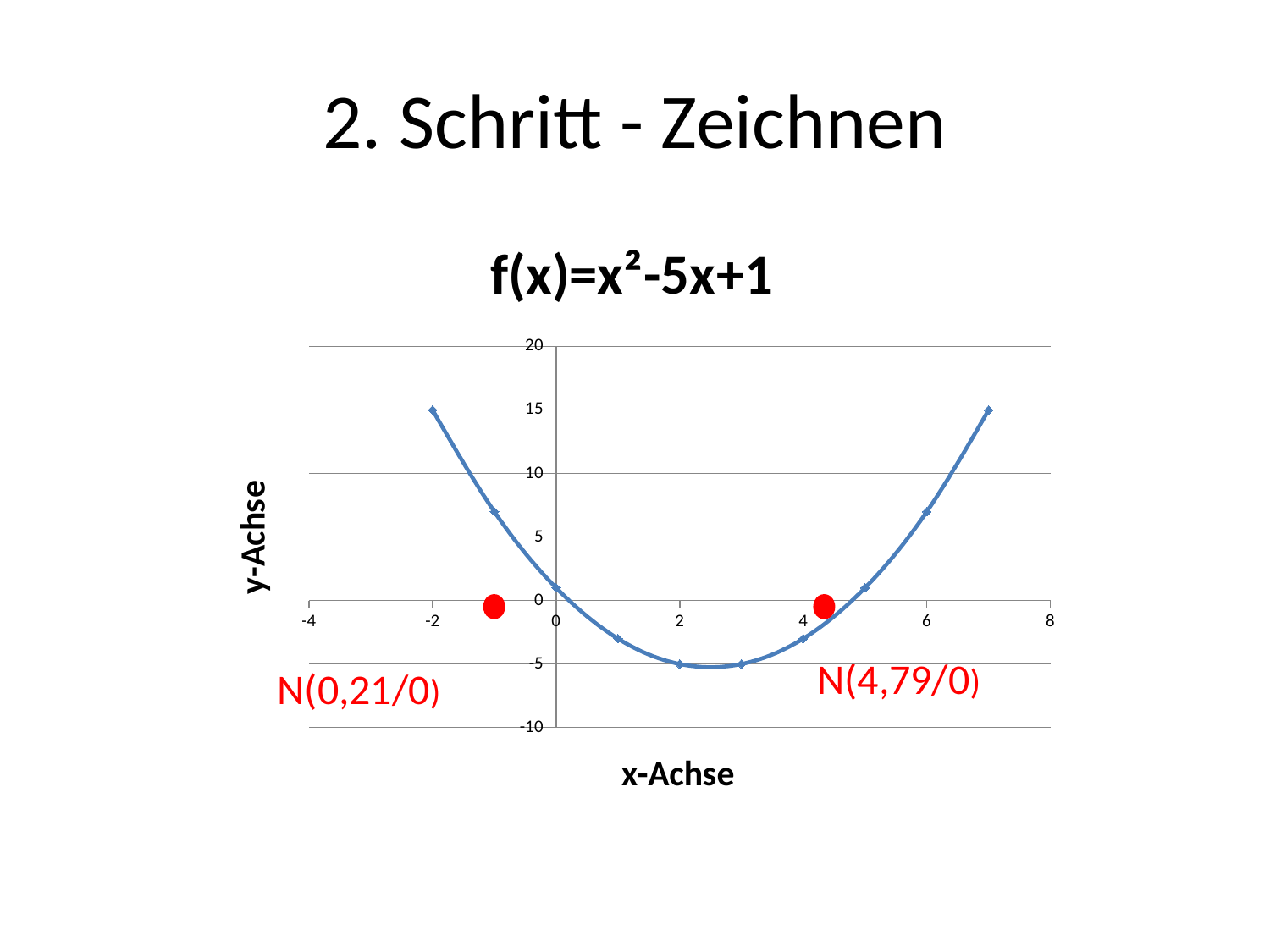
Is the y value of the plotted point at x = -1 greater or less than 5? greater What is the y value of the plotted point at x = 2? -5 What are the two red-labelled points marked on the chart? N(0,21/0) and N(4,79/0) What kind of chart is shown on the slide? line chart What is the y value of the plotted point at x = -2? 15 How many data points are plotted on the curve? 10 What is the y value of the plotted point at x = 3? -5 Is the y value of the plotted point at x = 1 greater or less than 0? less What is the title of the chart? f(x)=x²-5x+1 What is the y value of the plotted point at x = 7? 15 Which plotted point has the larger y value, the one at x = -2 or the one at x = 2? x = -2 What is the difference between the y value at x = 7 and the y value at x = 3? 20